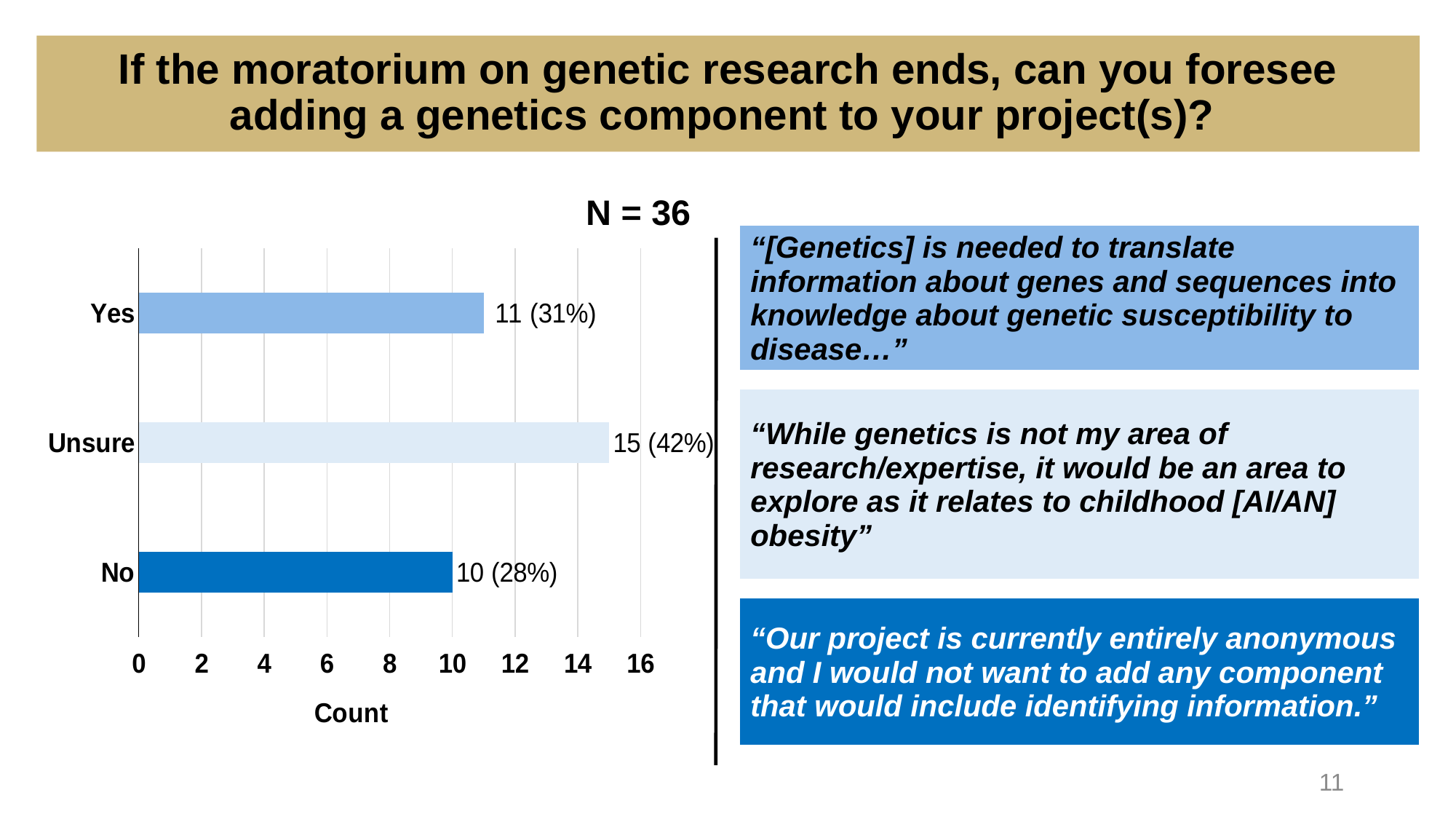
What percentage is shown for the Unsure category? 42% What is the label of the horizontal axis of the chart? Count How many categories are shown in the chart? 3 Which category has the highest count? Unsure Which has a larger count, Yes or No? Yes Which category has the lowest count? No What is the difference between the counts for Unsure and No? 5 What kind of chart is shown on the slide? bar chart Is the count for Unsure greater or less than 14? greater What is the count for the Yes category? 11 What is the count for the No category? 10 What is the count for the Unsure category? 15